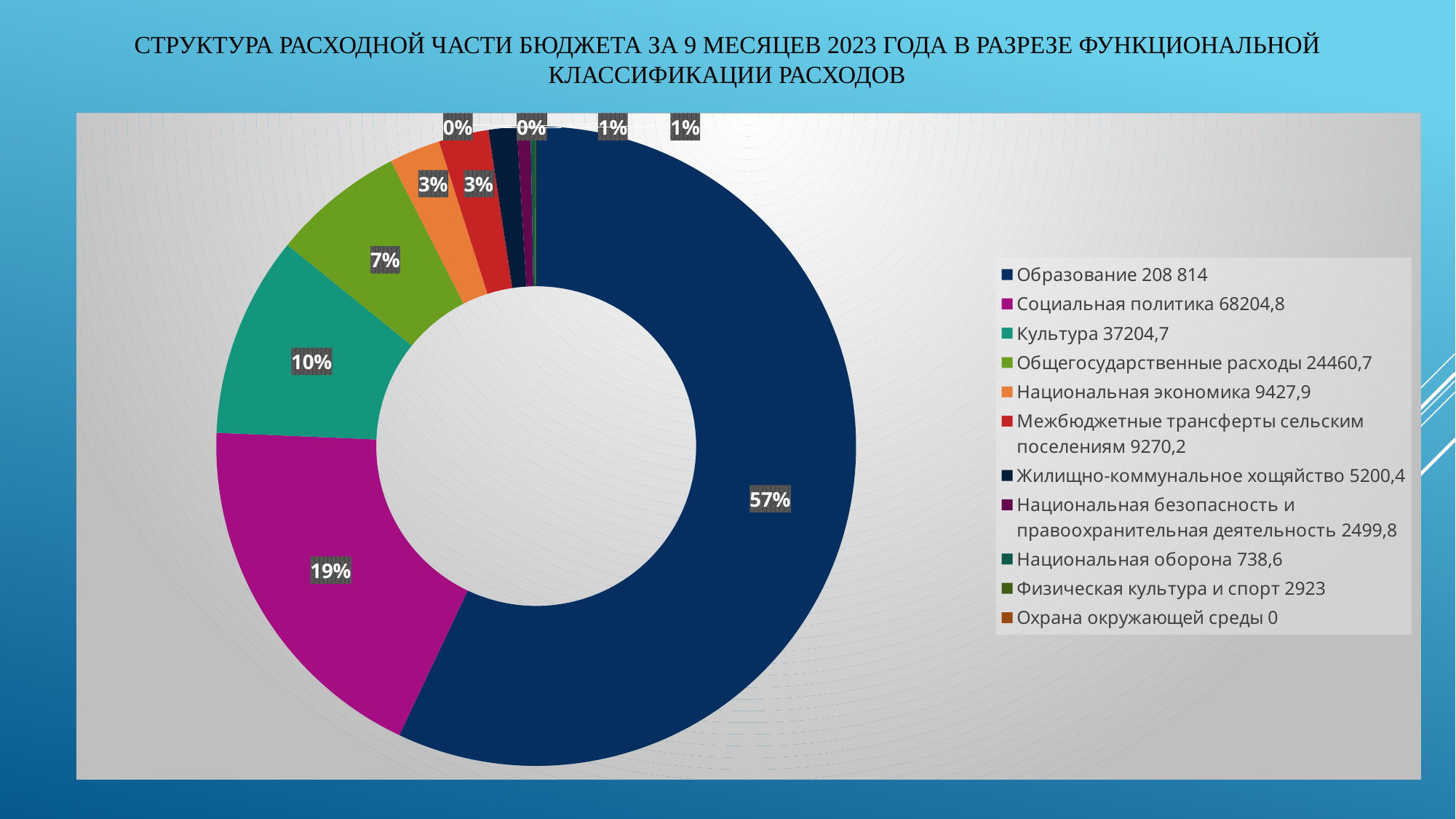
What is the difference between the legend values for Культура (37204,7) and Общегосударственные расходы (24460,7)? 12744 Which category has the largest share of the pie? Образование What share of the pie does Образование take? 57% What value is shown in the legend for Жилищно-коммунальное хозяйство? 5200,4 What share of the pie does Социальная политика take? 19% What share of the pie does Общегосударственные расходы take? 7% What kind of chart is shown on the slide? Pie (doughnut) chart How many categories does the legend list? 11 Which is larger, the value for Культура or the value for Общегосударственные расходы? Культура What value is shown in the legend for Национальная экономика? 9427,9 Which category has the smallest value in the legend? Охрана окружающей среды